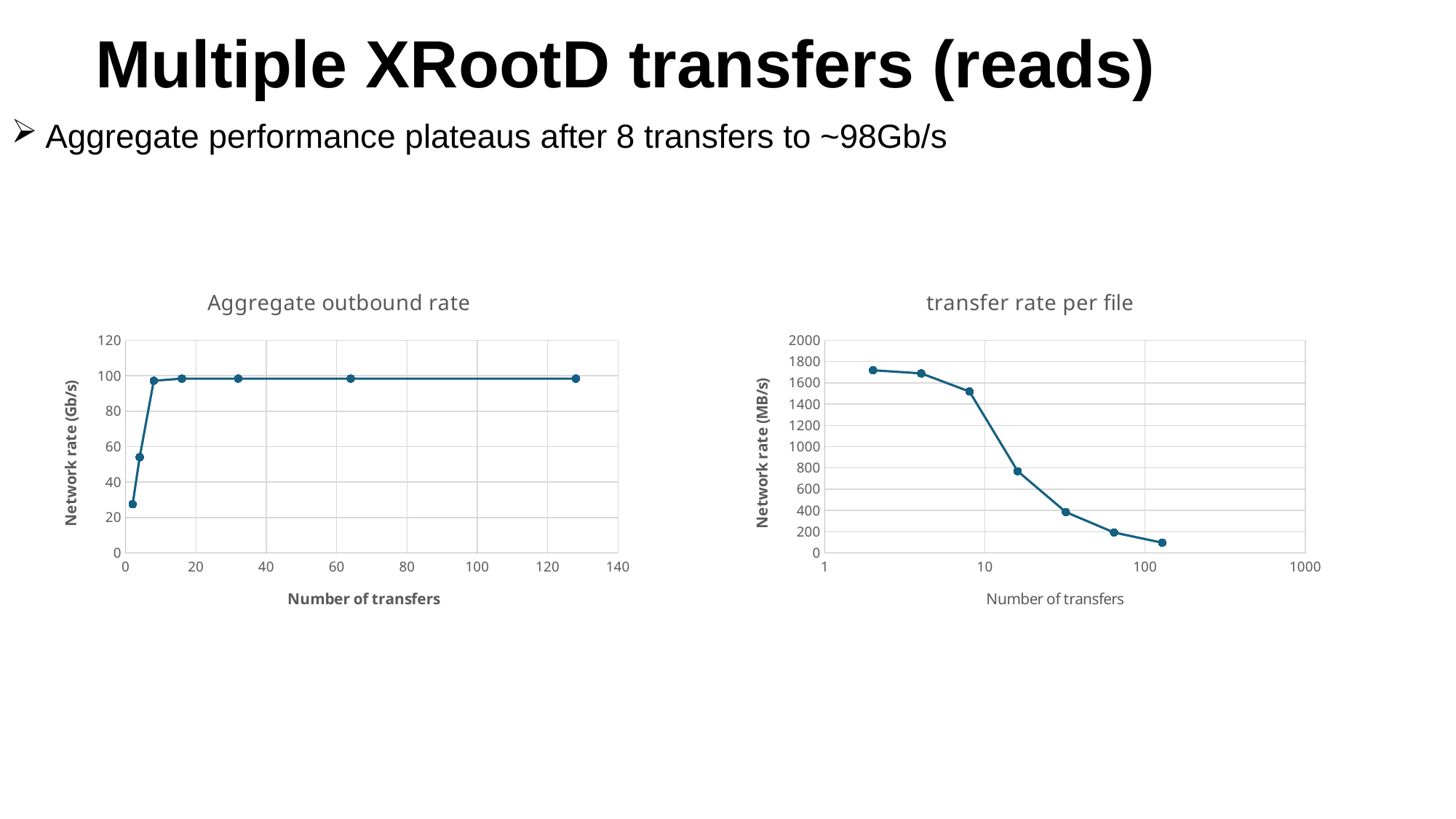
On the 'Aggregate outbound rate' chart, do the values rise or fall between 2 and 8 transfers? rise How many data points are plotted on the 'transfer rate per file' chart? 7 On the 'transfer rate per file' chart, at which number of transfers is the network rate lowest? 128 On the 'Aggregate outbound rate' chart, is the value at 2 transfers greater or less than 40? less What kind of chart is the 'transfer rate per file' chart? line chart On the 'transfer rate per file' chart, is the value at 16 transfers greater or less than 1000? less What kind of chart is the 'Aggregate outbound rate' chart? line chart What is the y-axis label of the 'transfer rate per file' chart? Network rate (MB/s) On the 'Aggregate outbound rate' chart, which is larger: the value at 2 transfers or the value at 8 transfers? 8 transfers On the 'transfer rate per file' chart, do the values rise or fall as the number of transfers increases? fall How many data points are plotted on the 'Aggregate outbound rate' chart? 7 On the 'Aggregate outbound rate' chart, is the value at 128 transfers greater or less than 80? greater